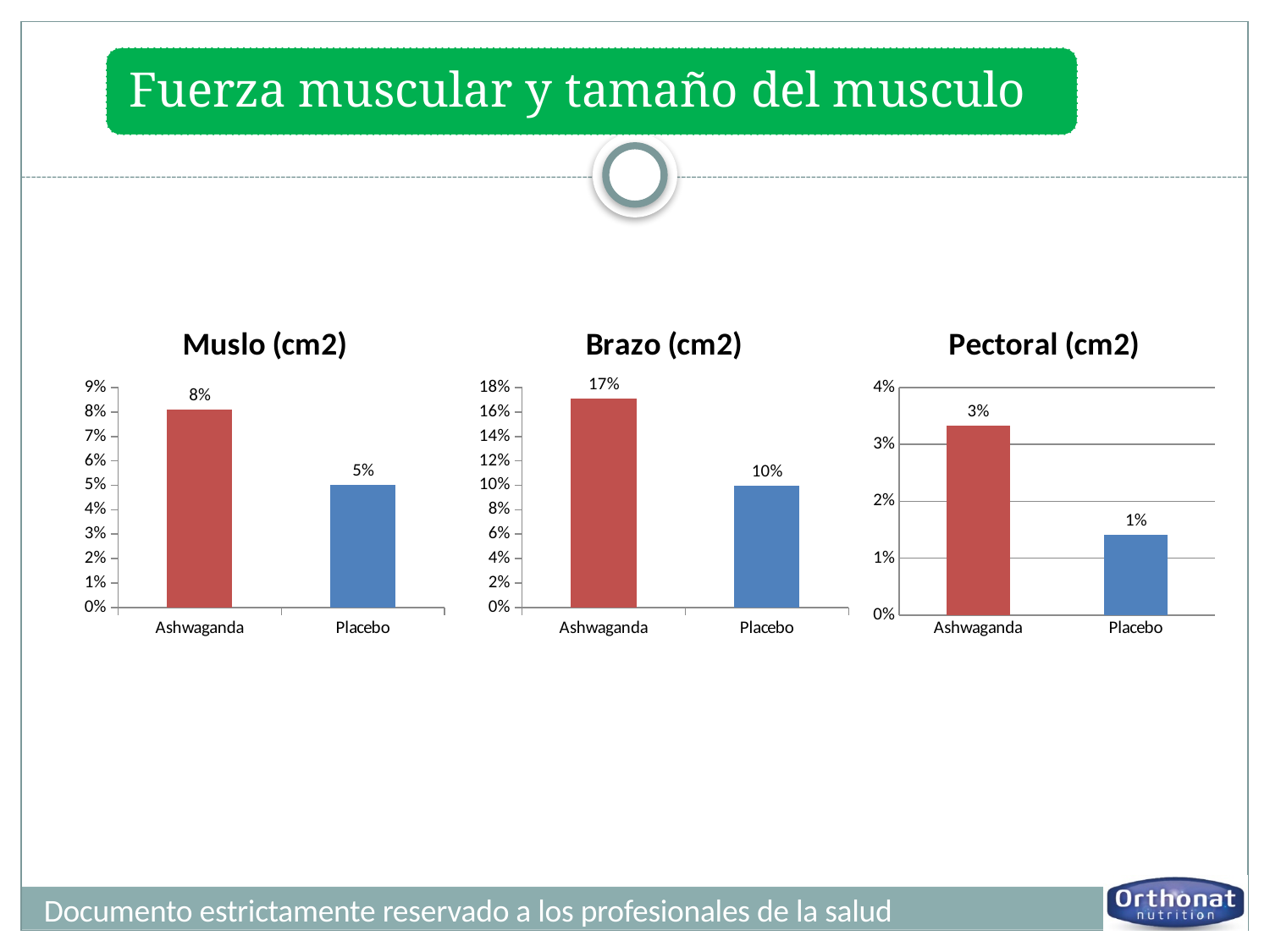
In the Pectoral (cm2) chart, what is the value for Placebo? 1% In the Brazo (cm2) chart, what is the value for Placebo? 10% In the Brazo (cm2) chart, what is the difference between the Ashwaganda and Placebo values? 7% What kind of chart is the Brazo (cm2) chart? Bar chart In the Muslo (cm2) chart, which category has the lowest value? Placebo In the Pectoral (cm2) chart, is the value for Ashwaganda greater or less than 2%? greater In the Pectoral (cm2) chart, what is the value for Ashwaganda? 3% In the Brazo (cm2) chart, which category has the highest value? Ashwaganda In the Muslo (cm2) chart, what is the difference between the Ashwaganda and Placebo values? 3% In the Muslo (cm2) chart, what is the value for Ashwaganda? 8% In the Muslo (cm2) chart, what is the value for Placebo? 5% In the Brazo (cm2) chart, what is the value for Ashwaganda? 17%